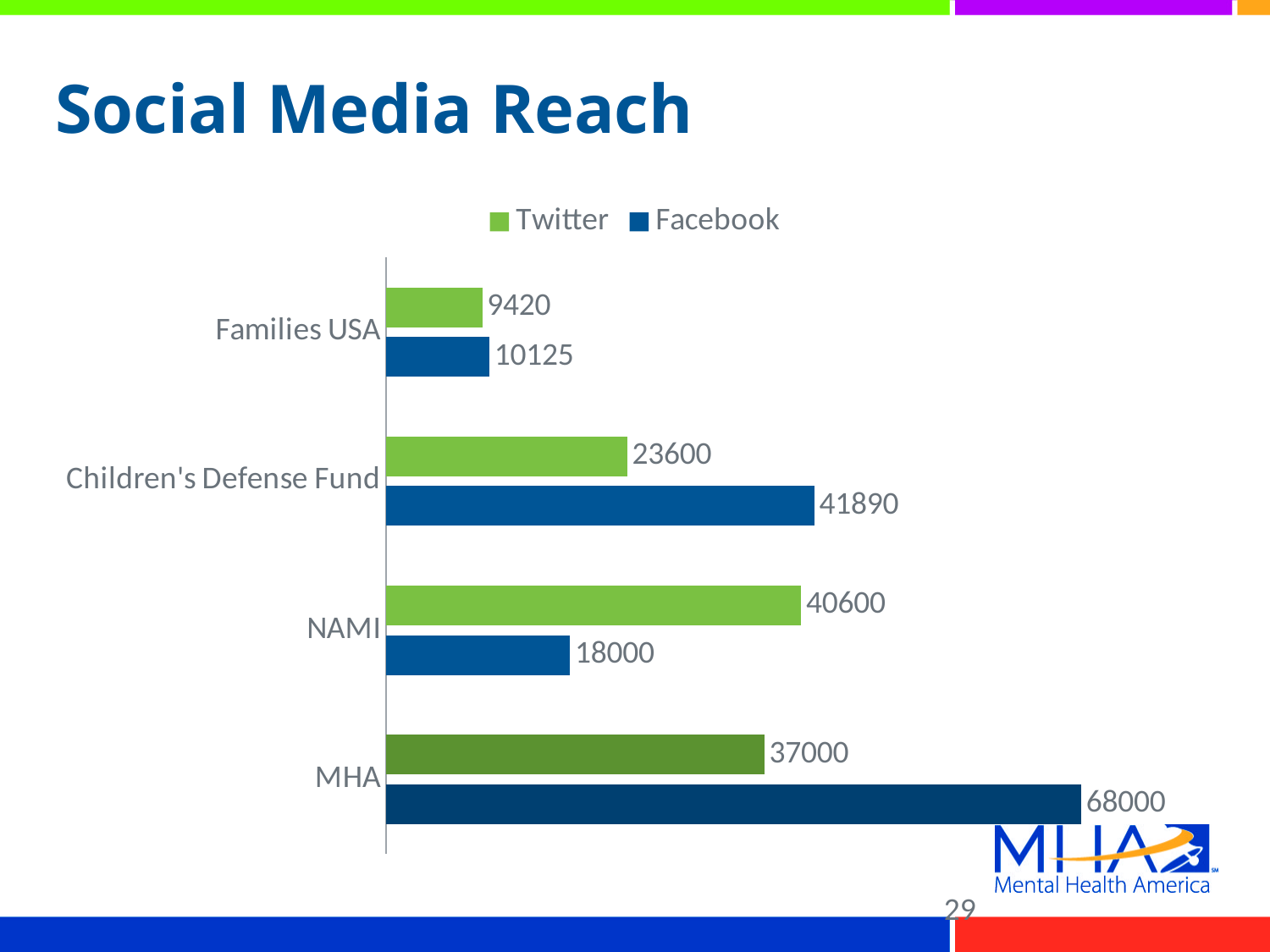
What is the Facebook value for Children's Defense Fund? 41890 How many series does the legend list? 2 Which organization has the lowest Twitter value? Families USA Which organization has the highest Facebook value? MHA How many organizations are shown on the chart? 4 What kind of chart is shown on the slide? Bar chart What is the Twitter value for NAMI? 40600 What is the Facebook value for MHA? 68000 What is the difference between the Facebook and Twitter values for MHA? 31000 For NAMI, which is larger, the Twitter value or the Facebook value? Twitter What is the Twitter value for Families USA? 9420 What is the difference between the Twitter values for NAMI and Children's Defense Fund? 17000